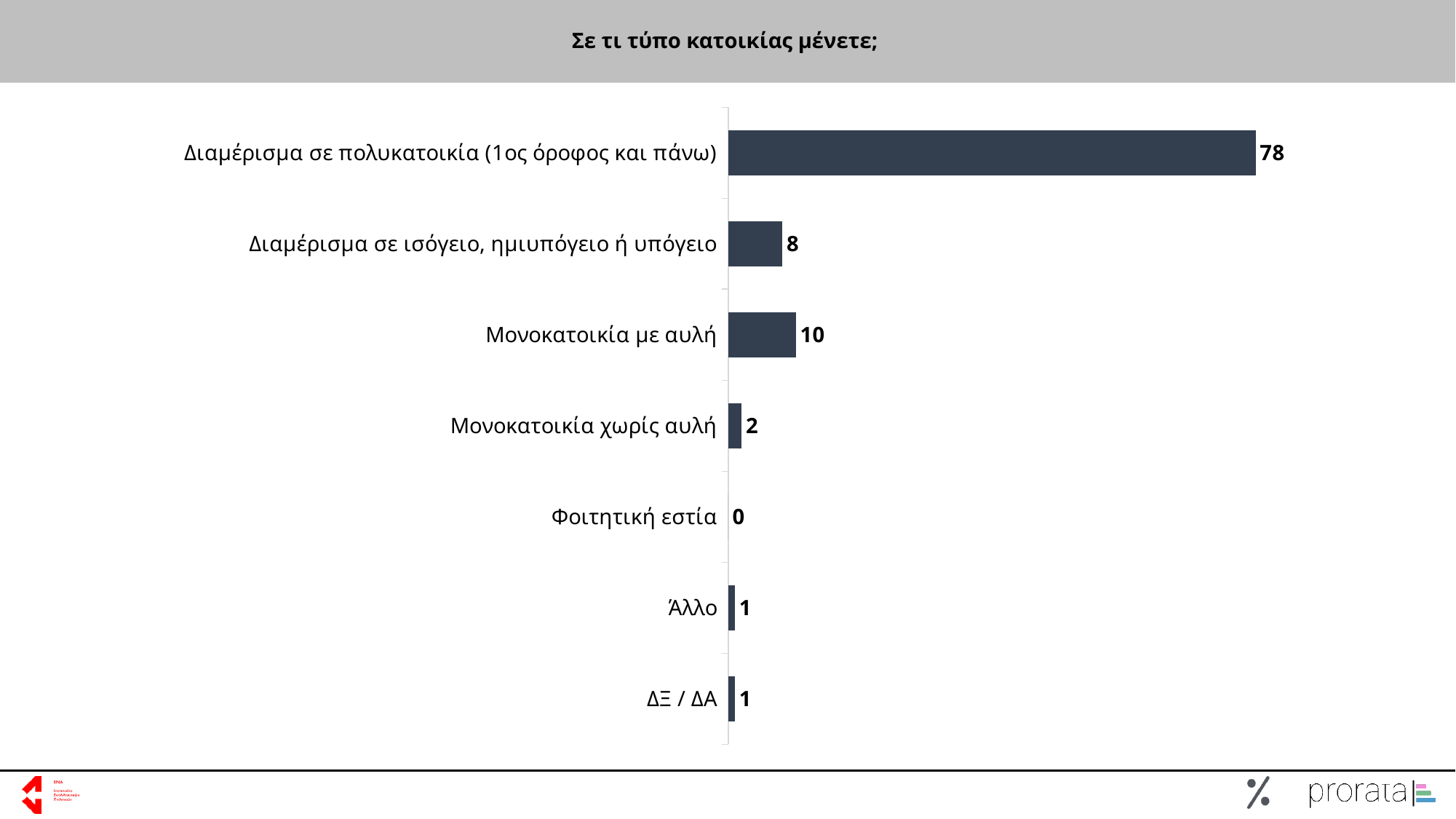
What is the value for Διαμέρισμα σε ισόγειο, ημιυπόγειο ή υπόγειο? 8 What is the value for Διαμέρισμα σε πολυκατοικία (1ος όροφος και πάνω)? 78 What is the value for Μονοκατοικία με αυλή? 10 Which category has the lowest value? Φοιτητική εστία What is the value for Φοιτητική εστία? 0 What is the difference between the values for Διαμέρισμα σε πολυκατοικία (1ος όροφος και πάνω) and Μονοκατοικία με αυλή? 68 What is the title of the chart? Σε τι τύπο κατοικίας μένετε; What is the value for Μονοκατοικία χωρίς αυλή? 2 How many categories are shown in the chart? 7 What kind of chart is shown on the slide? Bar chart Which is larger: the value for Μονοκατοικία με αυλή or the value for Διαμέρισμα σε ισόγειο, ημιυπόγειο ή υπόγειο? Μονοκατοικία με αυλή Which category has the highest value? Διαμέρισμα σε πολυκατοικία (1ος όροφος και πάνω)